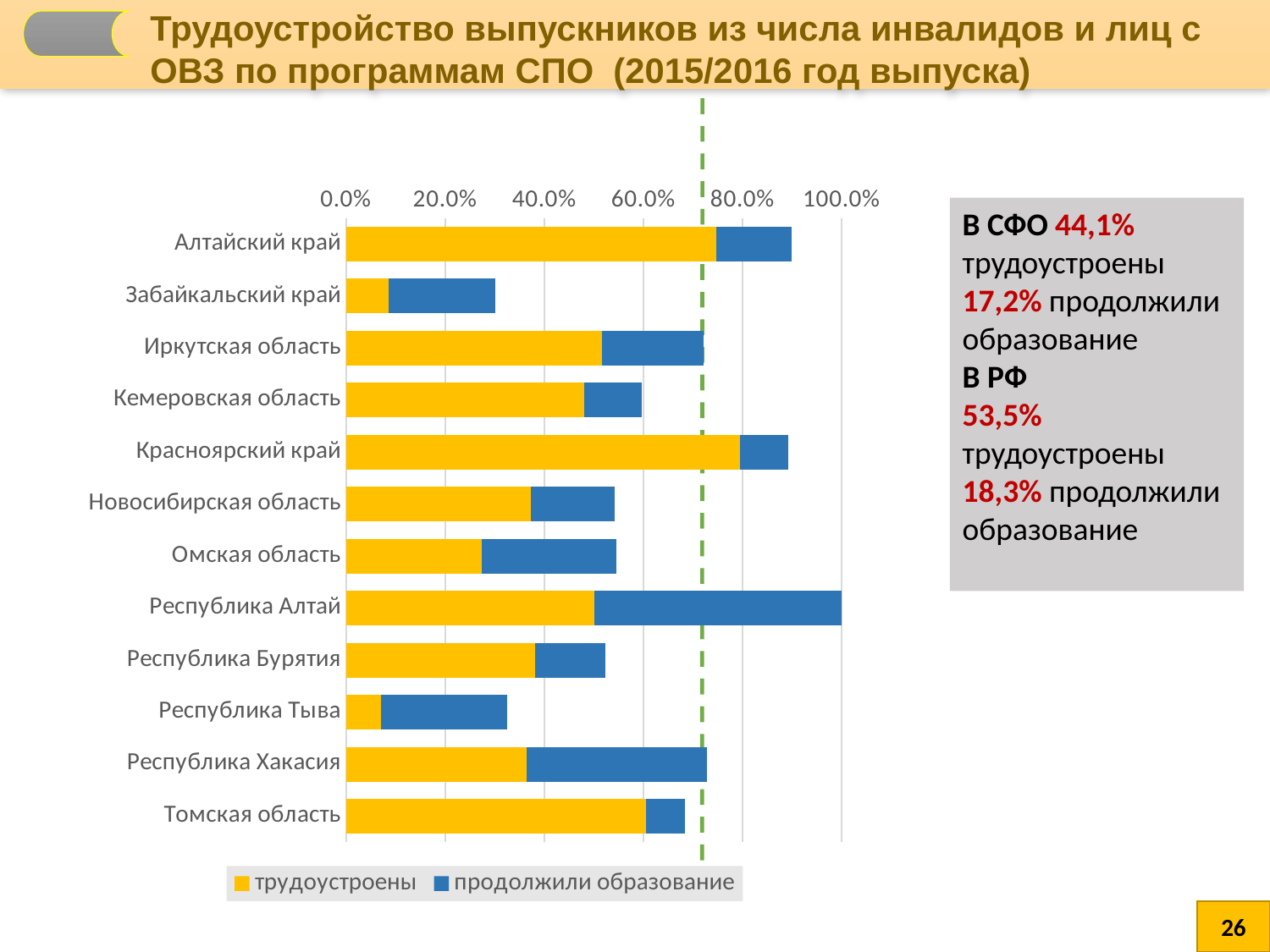
Is the 'трудоустроены' value for Алтайский край greater or less than 60.0%? greater What are the two series named in the chart legend? трудоустроены, продолжили образование Which region has the largest 'продолжили образование' segment? Республика Алтай Which region has the larger 'трудоустроены' value, Алтайский край or Омская область? Алтайский край How many series does the chart legend list? 2 Is the 'трудоустроены' value for Забайкальский край greater or less than 20.0%? less How many regions are listed on the chart? 12 Which colour represents the series 'трудоустроены' in the chart? yellow Which region has the longer total bar, Республика Алтай or Томская область? Республика Алтай Which region has the longest total bar (employed plus continued education)? Республика Алтай What kind of chart is shown on the slide? bar chart Is the total bar length for Республика Тыва greater or less than 40.0%? less